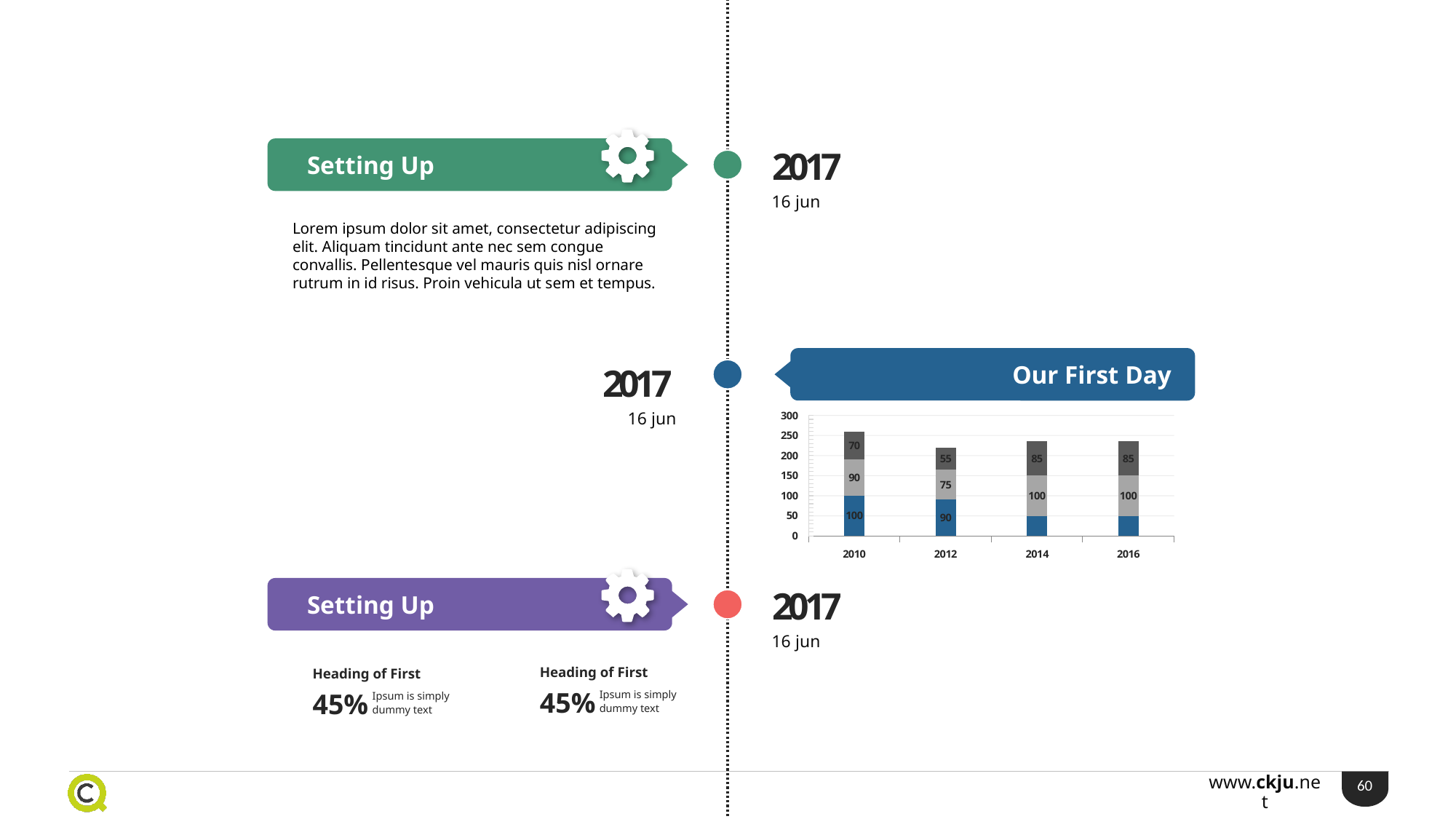
In the 'Our First Day' chart, what is the value of the top (dark gray) segment for 2010? 70 How many years are shown on the x axis of the 'Our First Day' chart? 4 In the 'Our First Day' chart, what is the value of the top (dark gray) segment for 2016? 85 In the 'Our First Day' chart, which year has the larger middle (light gray) segment, 2010 or 2014? 2014 In the 'Our First Day' chart, which year has the tallest stacked bar? 2010 In the 'Our First Day' chart, what is the total of the stacked bar for 2012? 220 In the 'Our First Day' chart, is the bottom (blue) segment for 2014 greater or less than 100? less In the 'Our First Day' chart, what is the value of the bottom (blue) segment for 2010? 100 In the 'Our First Day' chart, what is the value of the middle (light gray) segment for 2012? 75 What kind of chart is shown under the 'Our First Day' heading? Stacked bar chart In the 'Our First Day' chart, what is the total of the stacked bar for 2010? 260 In the 'Our First Day' chart, what is the difference between the top (dark gray) segment values for 2014 and 2012? 30